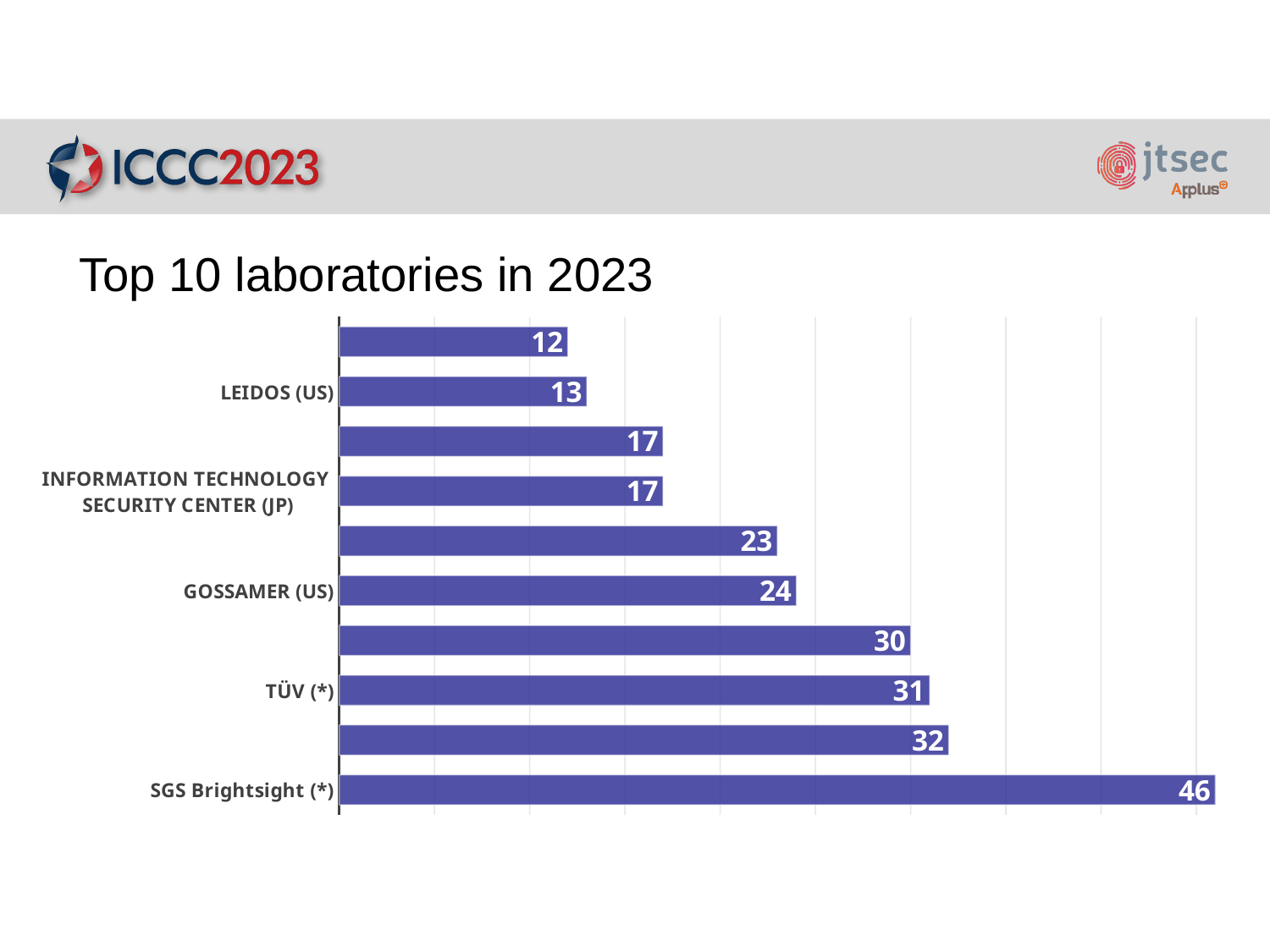
What is the value of the shortest bar in the chart? 12 What kind of chart is shown on the slide? Bar chart What is the difference between the values for TÜV (*) and GOSSAMER (US)? 7 What is the difference between the values for SGS Brightsight (*) and TÜV (*)? 15 How many bars are shown in the chart? 10 What is the value for LEIDOS (US)? 13 What is the value for INFORMATION TECHNOLOGY SECURITY CENTER (JP)? 17 What is the value for SGS Brightsight (*)? 46 What is the value for GOSSAMER (US)? 24 Which laboratory has the highest value? SGS Brightsight (*) What is the value for TÜV (*)? 31 Which has a larger value, GOSSAMER (US) or LEIDOS (US)? GOSSAMER (US)